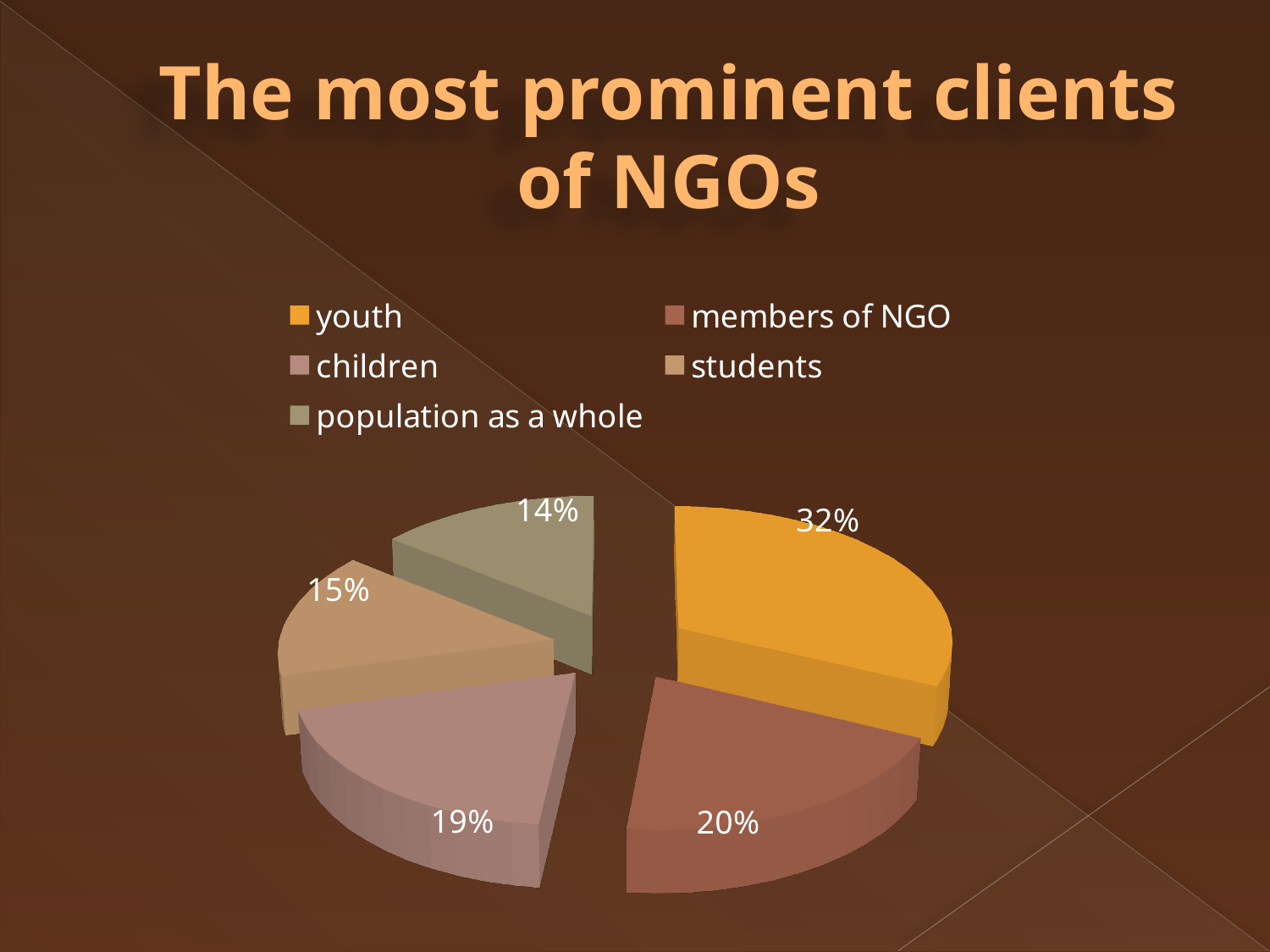
What share of the pie is the children slice? 19% What share of the pie is the members of NGO slice? 20% What share of the pie is the youth slice? 32% What is the difference between the youth share and the members of NGO share? 12% What is the title of the chart? The most prominent clients of NGOs What kind of chart is shown on the slide? pie chart Which category has the largest slice of the pie? youth How many categories does the legend list? 5 Which is larger, the students slice or the children slice? children Which category has the smallest slice of the pie? population as a whole